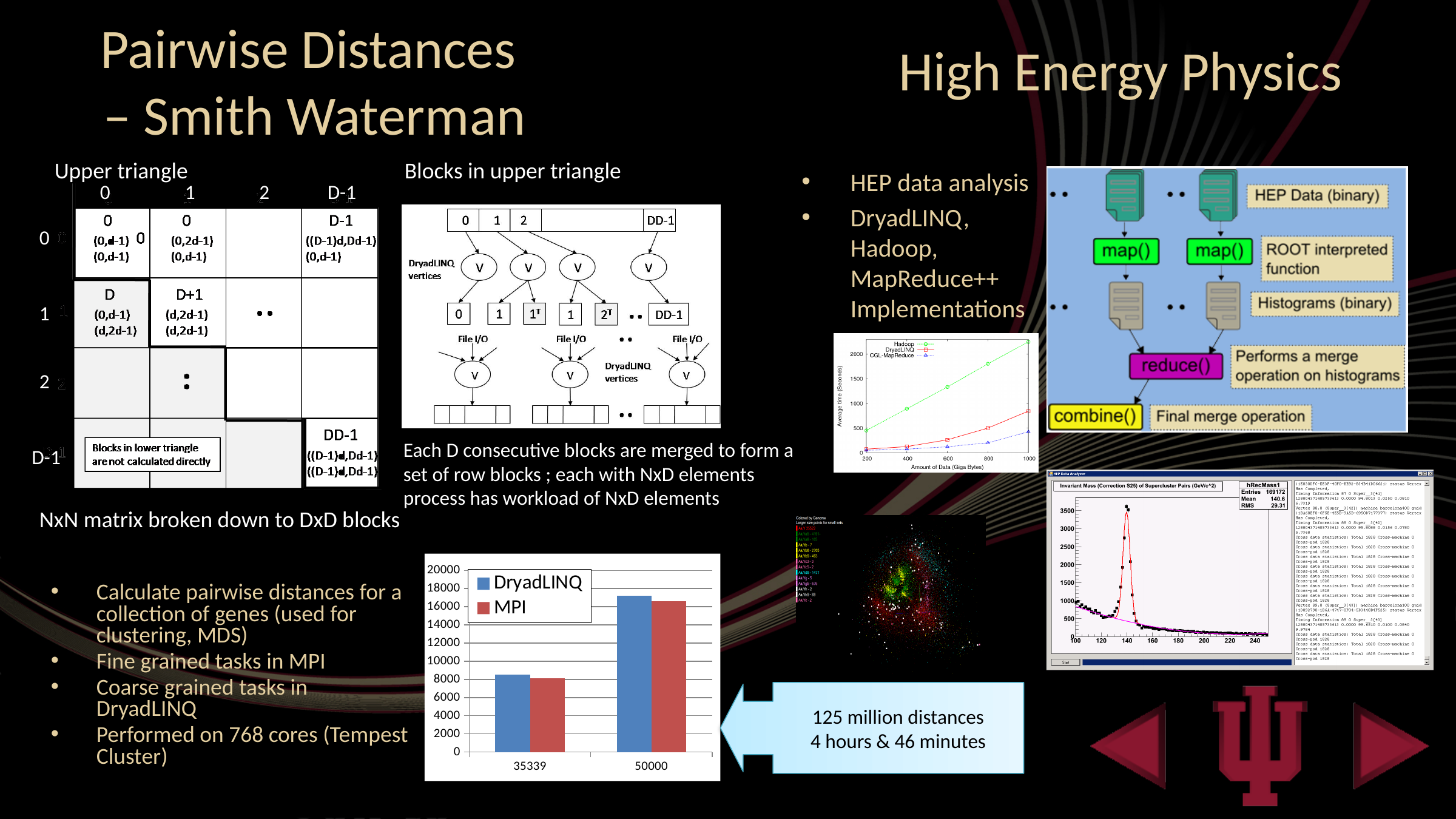
In the bottom-center bar chart, what are the two series named in the legend? DryadLINQ and MPI In the bottom-center bar chart, is the MPI value for 35339 greater or less than 10000? less In the bottom-center bar chart, which series is shown in blue? DryadLINQ In the bottom-center bar chart, do the values rise or fall from 35339 to 50000? rise In the bottom-center bar chart, is the DryadLINQ value for 50000 greater or less than 16000? greater In the bottom-center bar chart, how many categories are shown on the x axis? 2 In the bottom-center bar chart, how many series does the legend list? 2 In the bottom-center bar chart, which category has the higher DryadLINQ value, 35339 or 50000? 50000 In the line chart under the High Energy Physics heading, how many series does the legend list? 3 In the line chart under the High Energy Physics heading, is the Hadoop value at 1000 Giga Bytes greater or less than 2000? greater What kind of chart is the bar chart at the bottom center of the slide comparing DryadLINQ and MPI? bar chart In the line chart under the High Energy Physics heading, which series has the highest average time at 1000 Giga Bytes? Hadoop